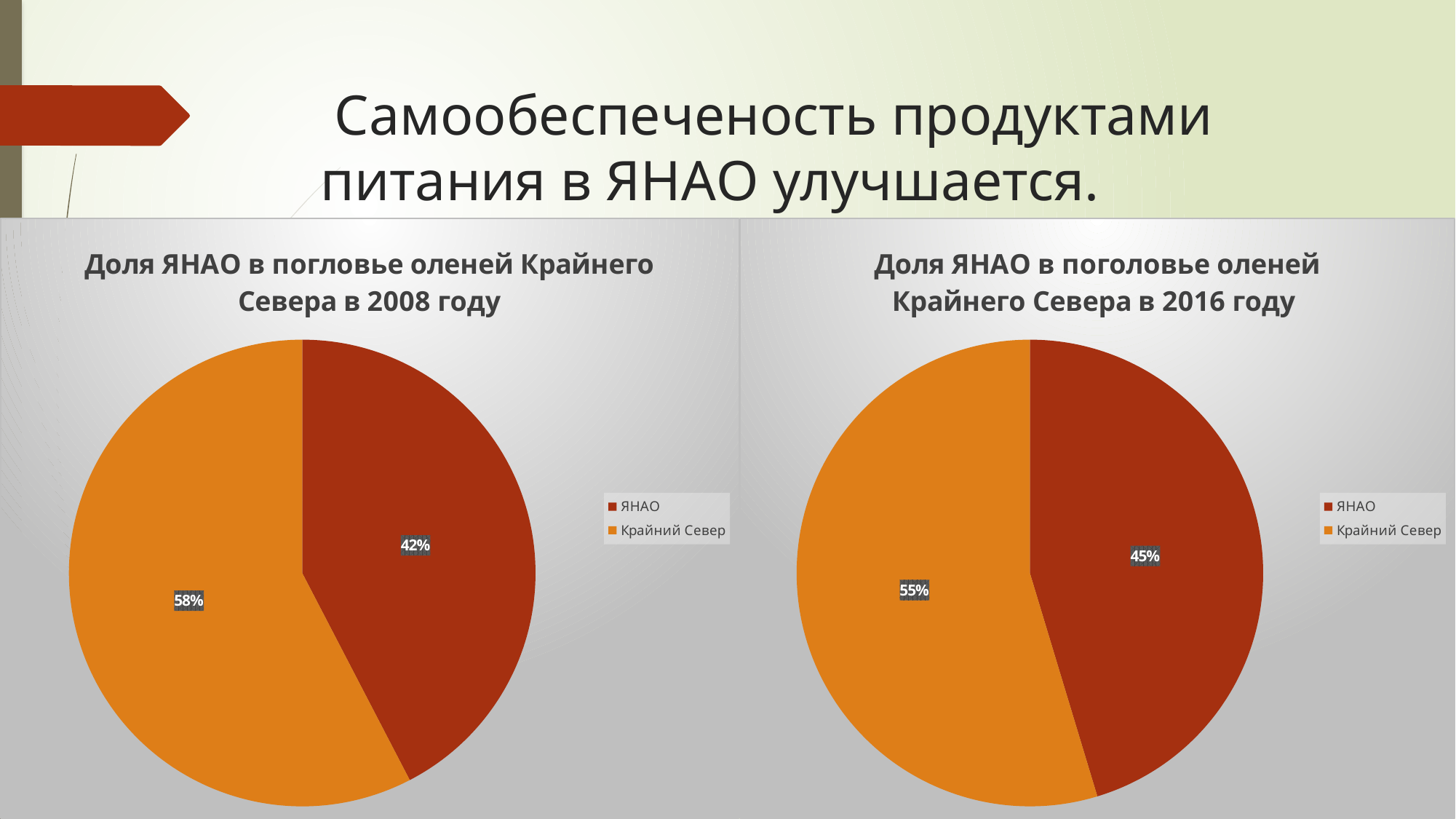
What type of chart is used on the left of the slide? pie chart In the right chart (2016), what share does Крайний Север have? 55% How many entries does the legend of the right chart (2016) list? 2 In the right chart (2016), which category has the smaller slice? ЯНАО In the left chart (2008), which category has the larger slice? Крайний Север In the right chart (2016), what share does ЯНАО have? 45% In the left chart (2008), what share does ЯНАО have? 42% Is the ЯНАО share larger in the left chart (2008) or the right chart (2016)? right chart (2016) In the right chart (2016), what is the difference between the Крайний Север and ЯНАО shares? 10% In the left chart (2008), what share does Крайний Север have? 58% What is the title of the right chart? Доля ЯНАО в поголовье оленей Крайнего Севера в 2016 году In the left chart (2008), what is the difference between the Крайний Север and ЯНАО shares? 16%